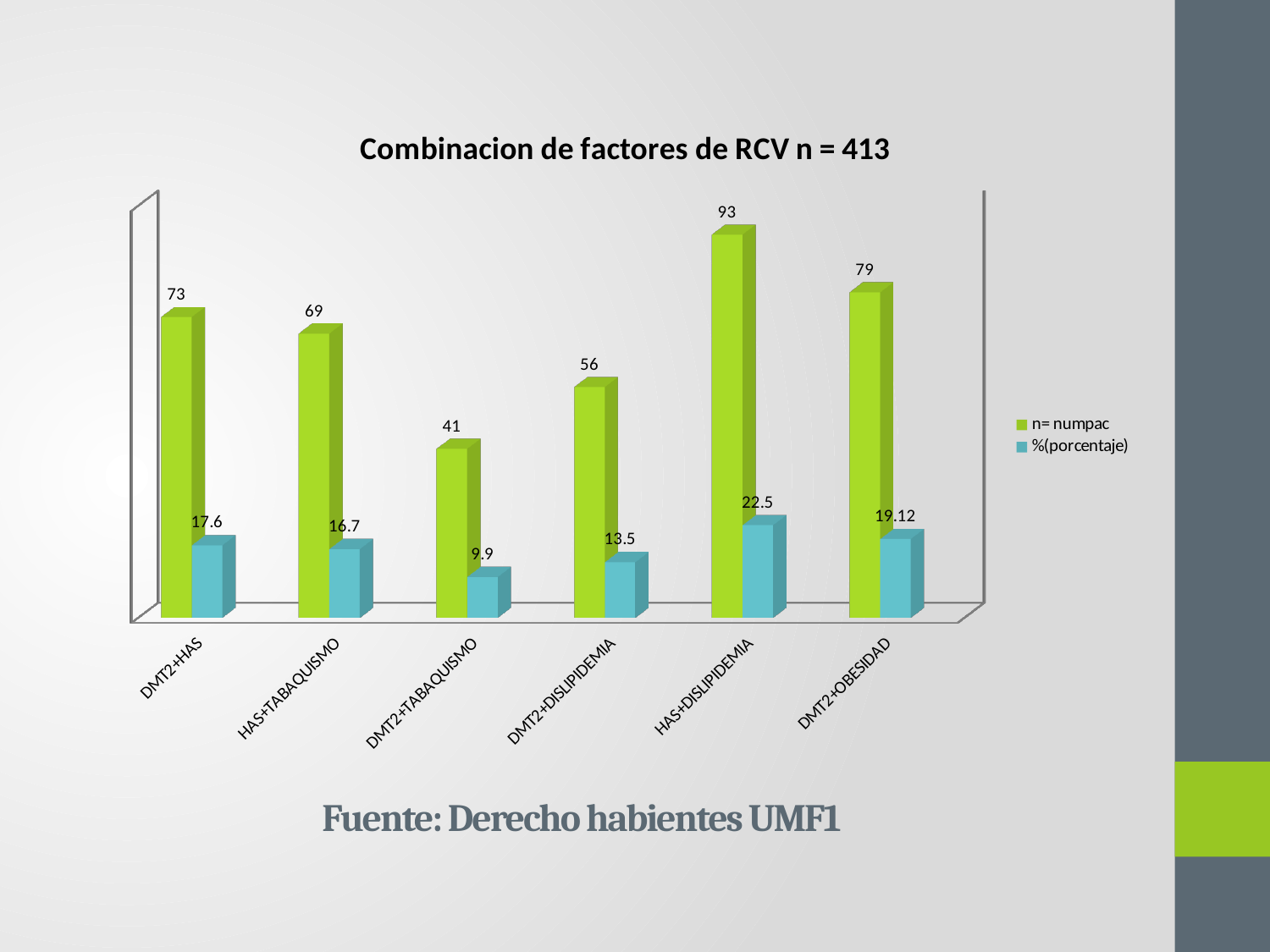
Which category has the highest n= numpac value? HAS+DISLIPIDEMIA Which has a larger n= numpac value, DMT2+HAS or HAS+TABAQUISMO? DMT2+HAS What is the %(porcentaje) value for DMT2+HAS? 17.6 What is the n= numpac value for HAS+DISLIPIDEMIA? 93 How many series does the legend list? 2 How many categories are shown on the x axis? 6 What is the n= numpac value for DMT2+OBESIDAD? 79 What is the title of the chart? Combinacion de factores de RCV n = 413 What is the difference in n= numpac between HAS+DISLIPIDEMIA and DMT2+TABAQUISMO? 52 Which category has the lowest %(porcentaje) value? DMT2+TABAQUISMO What kind of chart is shown on the slide? Bar chart What is the %(porcentaje) value for DMT2+TABAQUISMO? 9.9